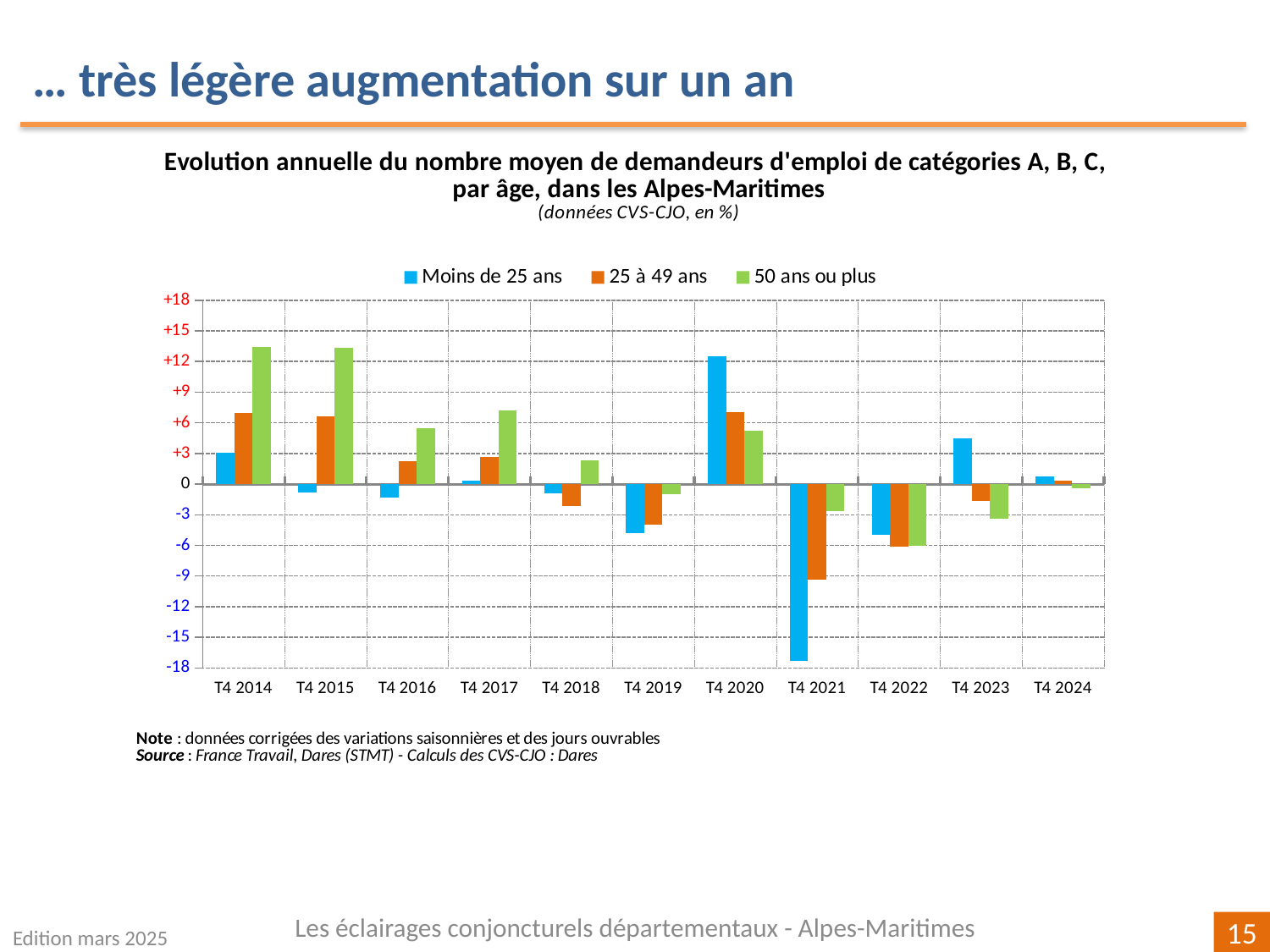
In T4 2020, which is larger: the value for 'Moins de 25 ans' or for '25 à 49 ans'? Moins de 25 ans Is the value for 'Moins de 25 ans' in T4 2020 greater or less than 9? greater Is the value for 'Moins de 25 ans' in T4 2021 greater or less than -15? less Is the value for '50 ans ou plus' in T4 2014 greater or less than 12? greater Which colour represents the '50 ans ou plus' series in the legend? green In which period is the value for 'Moins de 25 ans' the highest? T4 2020 How many series does the legend list? 3 In T4 2014, which series has the highest value? 50 ans ou plus What kind of chart is shown on the slide? bar chart How many periods (T4 years) are shown on the x axis? 11 In which period is the value for 'Moins de 25 ans' the lowest? T4 2021